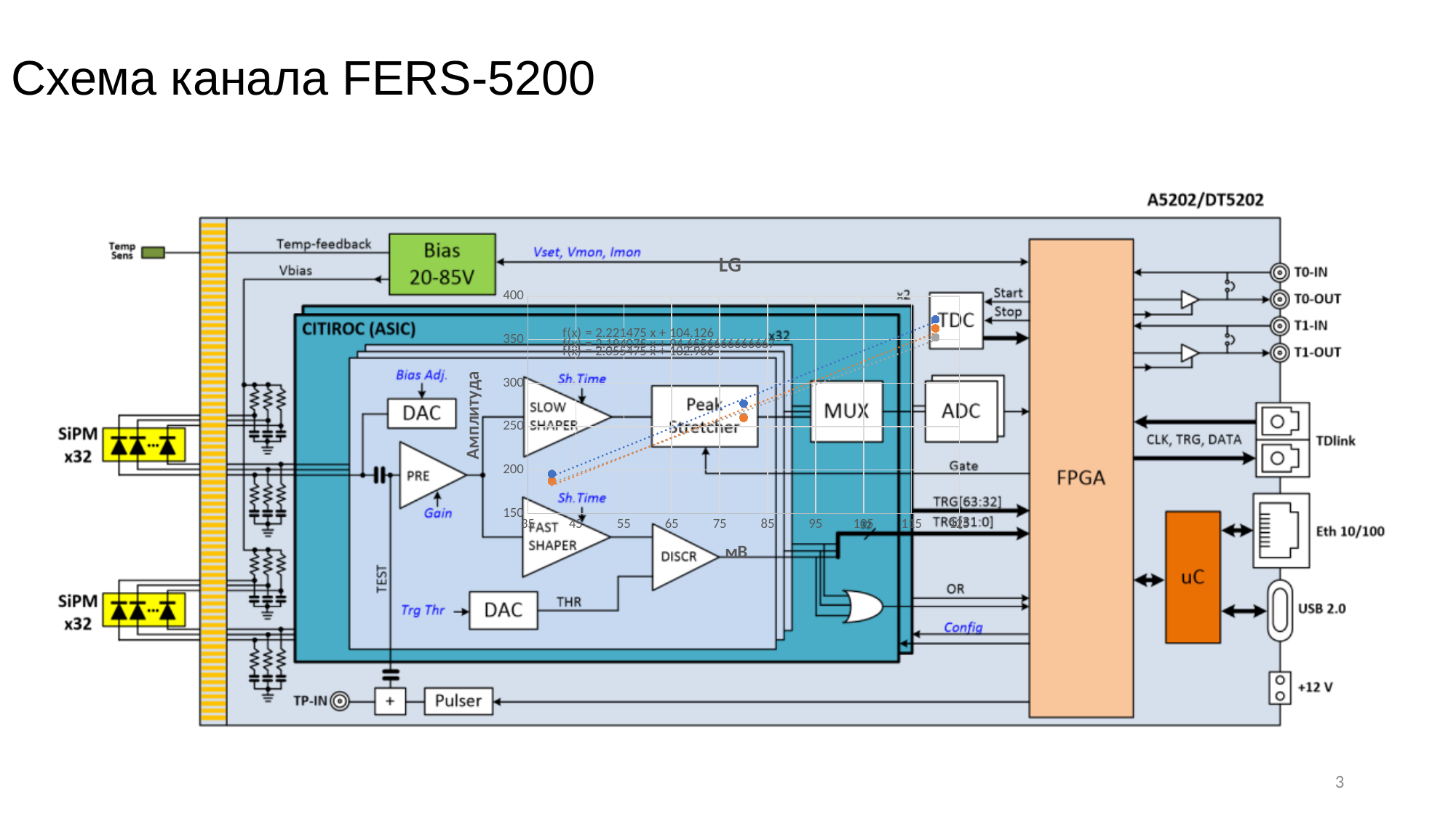
What is the title of the chart overlaid on the diagram? LG How many data points does the blue series have? 3 What is the label of the chart's vertical axis? Амплитуда Is the value of the blue series at x = 80 greater or less than 250? greater Do the plotted values rise or fall as the x-axis value increases? rise What is the highest tick value shown on the chart's vertical axis? 400 What kind of chart is overlaid on the block diagram? scatter chart